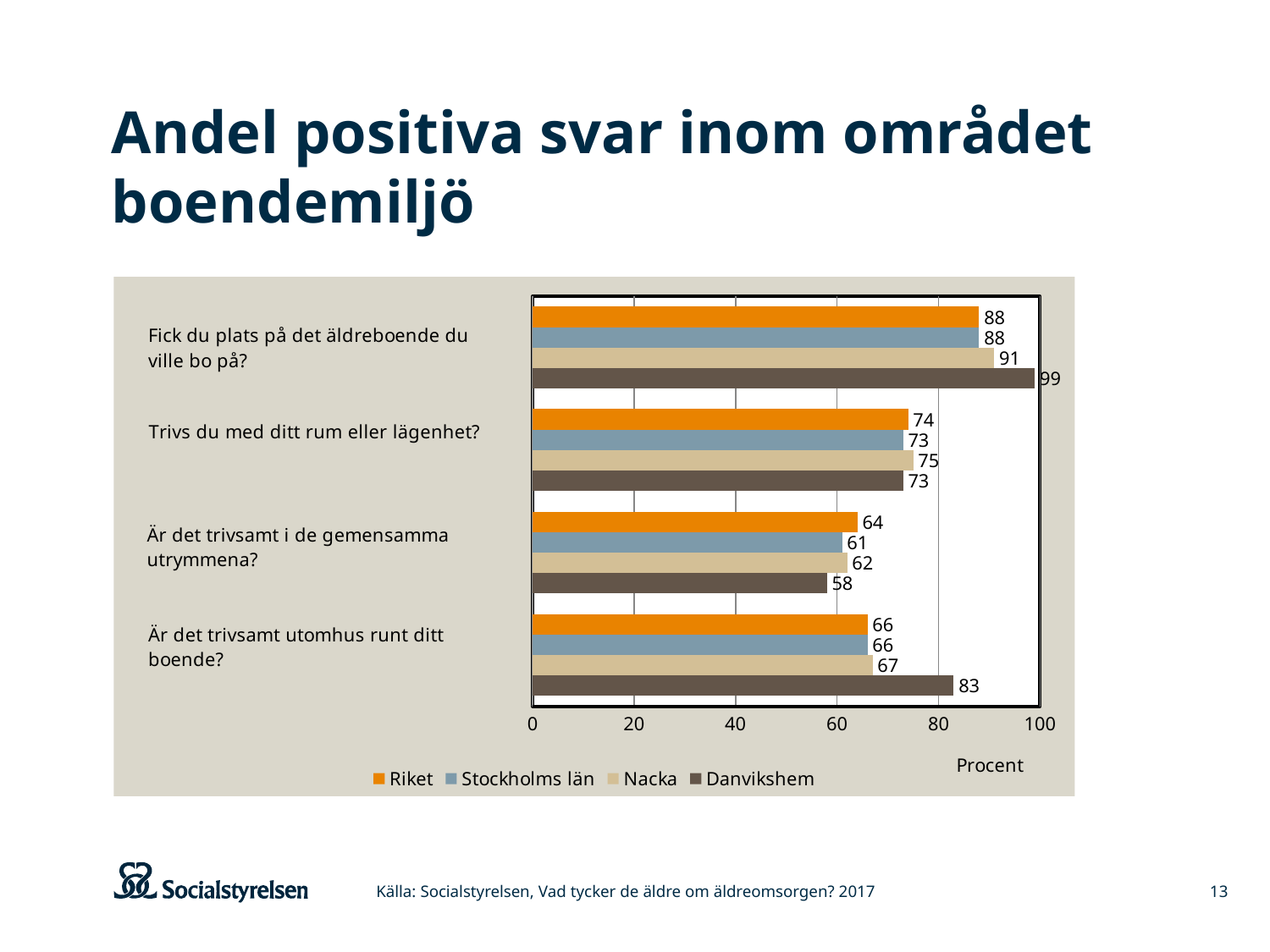
Which series has the highest value for "Är det trivsamt utomhus runt ditt boende?"? Danvikshem What kind of chart is shown on the slide? Bar chart Which is larger for "Fick du plats på det äldreboende du ville bo på?": the Nacka value or the Riket value? Nacka How many question categories are shown on the chart? 4 What is the value for Stockholms län for "Är det trivsamt utomhus runt ditt boende?"? 66 What is the difference between the Danvikshem and Nacka values for "Är det trivsamt utomhus runt ditt boende?"? 16 What is the label on the horizontal axis of the chart? Procent What is the value for Danvikshem for "Fick du plats på det äldreboende du ville bo på?"? 99 How many series does the legend list? 4 Which series has the lowest value for "Är det trivsamt i de gemensamma utrymmena?"? Danvikshem What is the value for Riket for "Är det trivsamt i de gemensamma utrymmena?"? 64 What is the value for Nacka for "Trivs du med ditt rum eller lägenhet?"? 75